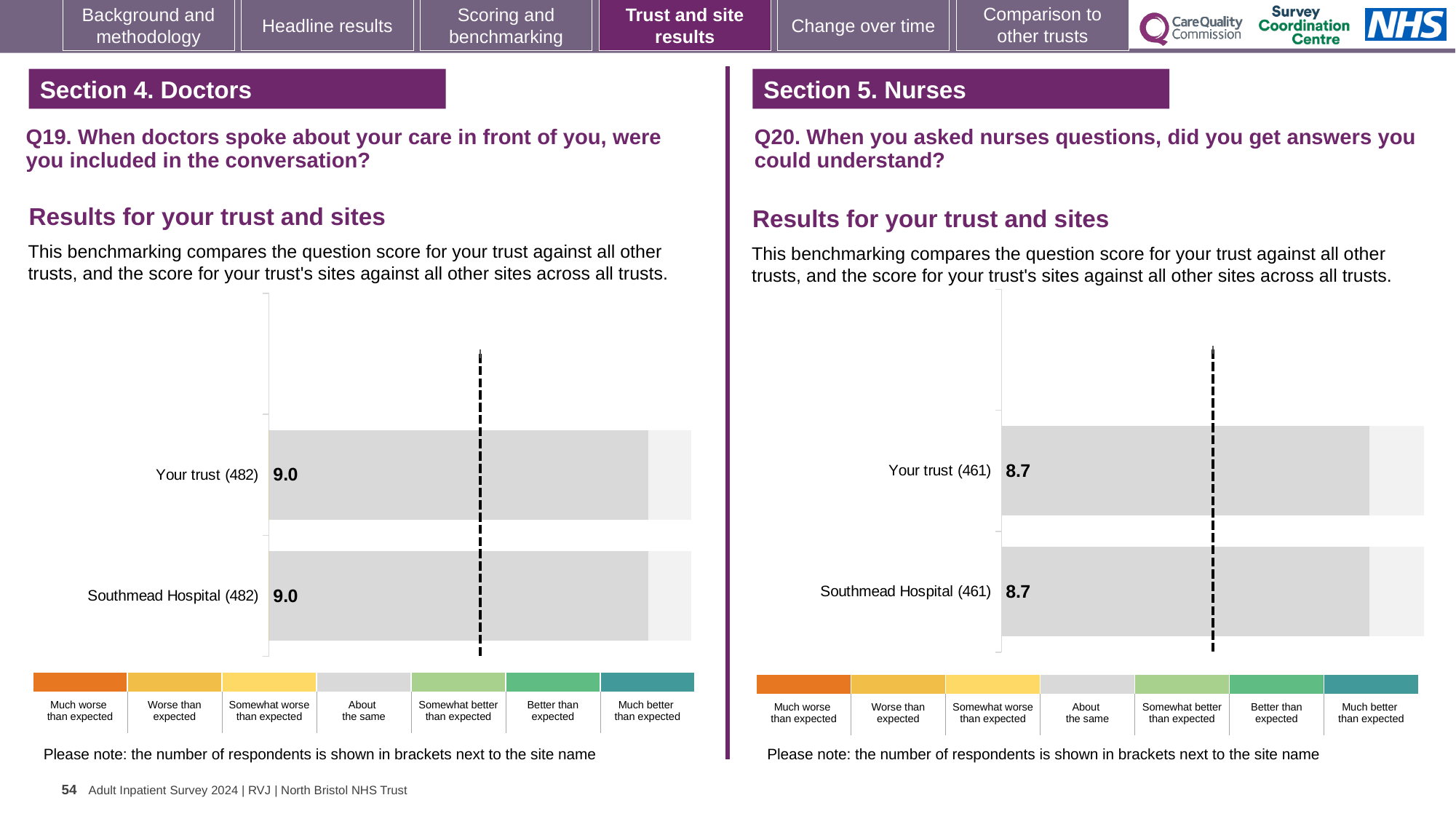
In the left chart (Q19, doctors), what is the score for Southmead Hospital? 9.0 What kind of chart is used in the left chart (Q19, doctors)? Bar chart In the left chart (Q19, doctors), how many bars are plotted? 2 In the right chart (Q20, nurses), what is the score for Southmead Hospital? 8.7 In the left chart (Q19, doctors), how many respondents are shown in brackets next to Your trust? 482 In the right chart (Q20, nurses), how many bars are plotted? 2 Which is larger: the Your trust score in the left chart (Q19, doctors) or the Your trust score in the right chart (Q20, nurses)? Left chart (Q19, doctors), 9.0 In the right chart (Q20, nurses), what is the score for Your trust? 8.7 In the left chart (Q19, doctors), what is the score for Your trust? 9.0 In the left chart (Q19, doctors), what is the difference between the Your trust score and the Southmead Hospital score? 0.0 In the right chart (Q20, nurses), how many respondents are shown in brackets next to Southmead Hospital? 461 In the right chart (Q20, nurses), what is the difference between the Your trust score and the Southmead Hospital score? 0.0